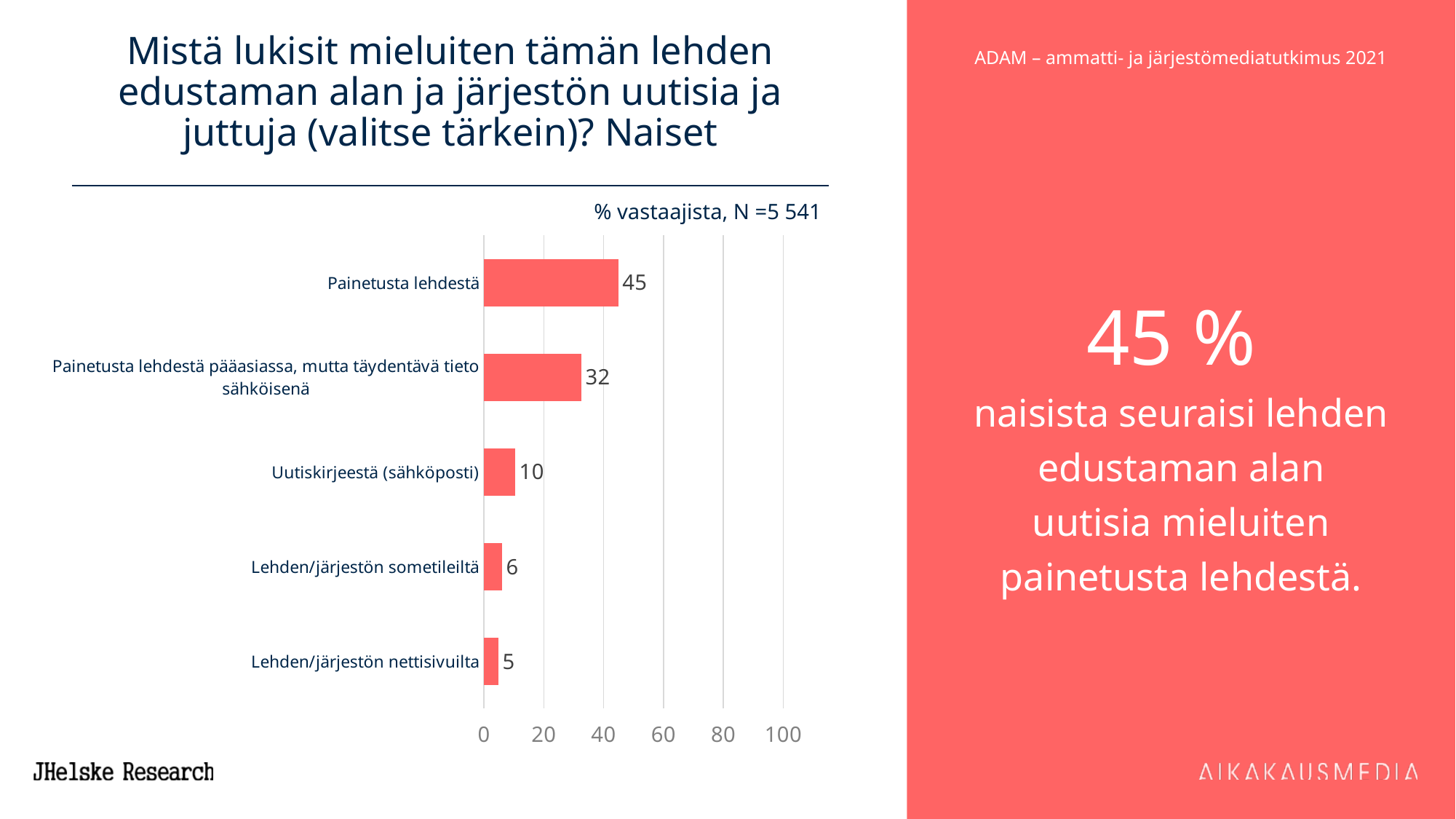
What is the value for Painetusta lehdestä pääasiassa, mutta täydentävä tieto sähköisenä? 32 What is the value for Painetusta lehdestä? 45 Which is larger: the value for Uutiskirjeestä (sähköposti) or the value for Lehden/järjestön sometileiltä? Uutiskirjeestä (sähköposti) What is the N (number of respondents) stated above the chart? 5 541 What is the value for Lehden/järjestön nettisivuilta? 5 Which category has the highest value? Painetusta lehdestä What kind of chart is shown on the slide? bar chart What is the value for Uutiskirjeestä (sähköposti)? 10 How many categories are shown in the chart? 5 Is the value for Painetusta lehdestä greater or less than 40? greater Which category has the lowest value? Lehden/järjestön nettisivuilta What is the difference between the values for Painetusta lehdestä and Painetusta lehdestä pääasiassa, mutta täydentävä tieto sähköisenä? 13